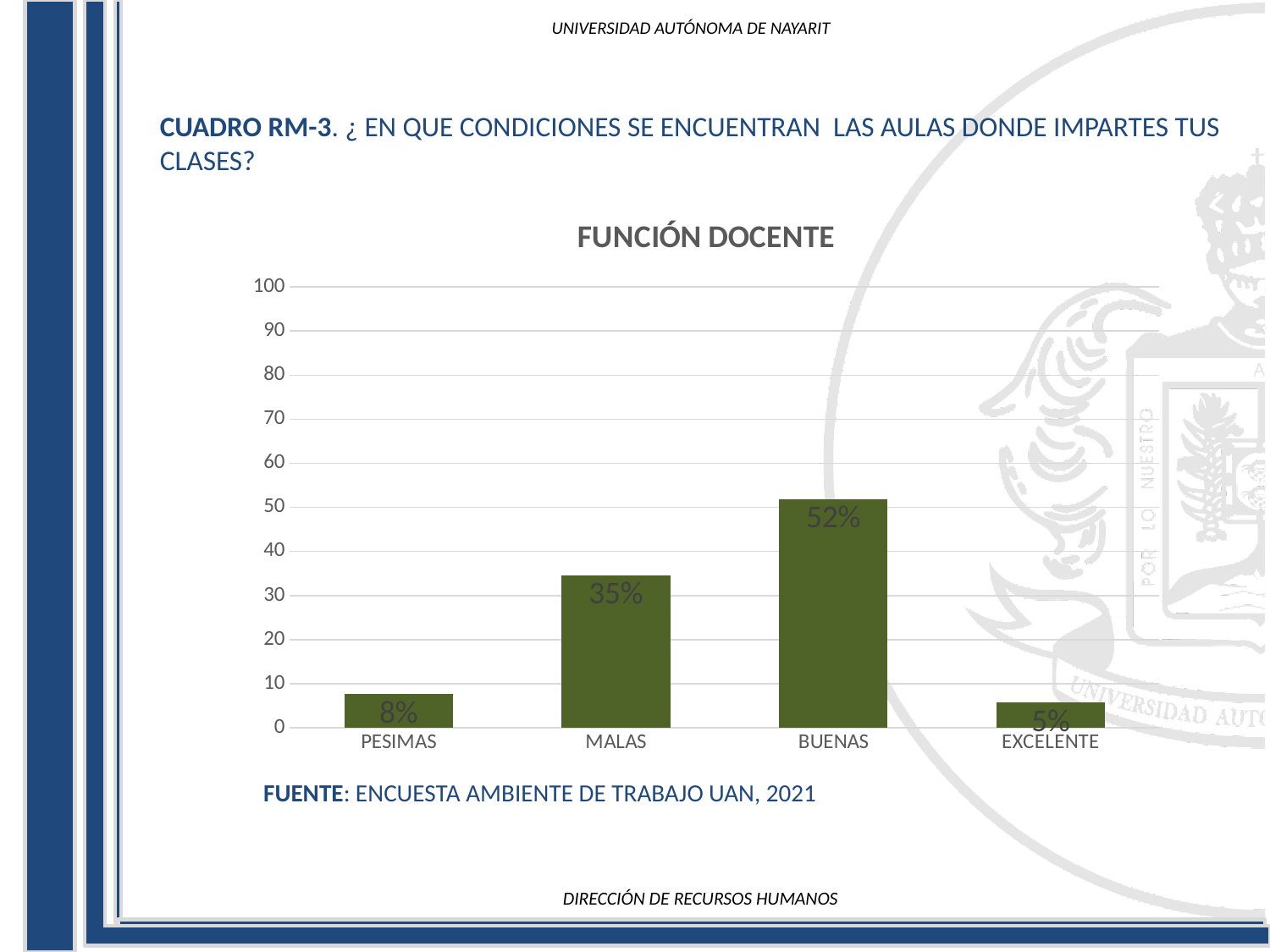
Which category has the lowest value? EXCELENTE What is the value for BUENAS? 52% What is the title of the chart? FUNCIÓN DOCENTE What is the difference between the values for BUENAS and MALAS? 17% What is the value for EXCELENTE? 5% What is the value for PESIMAS? 8% How many categories are shown on the x axis? 4 Which category has the highest value? BUENAS Which is larger, the value for PESIMAS or the value for EXCELENTE? PESIMAS What kind of chart is shown? bar chart Is the value for MALAS greater or less than 30? greater What is the value for MALAS? 35%